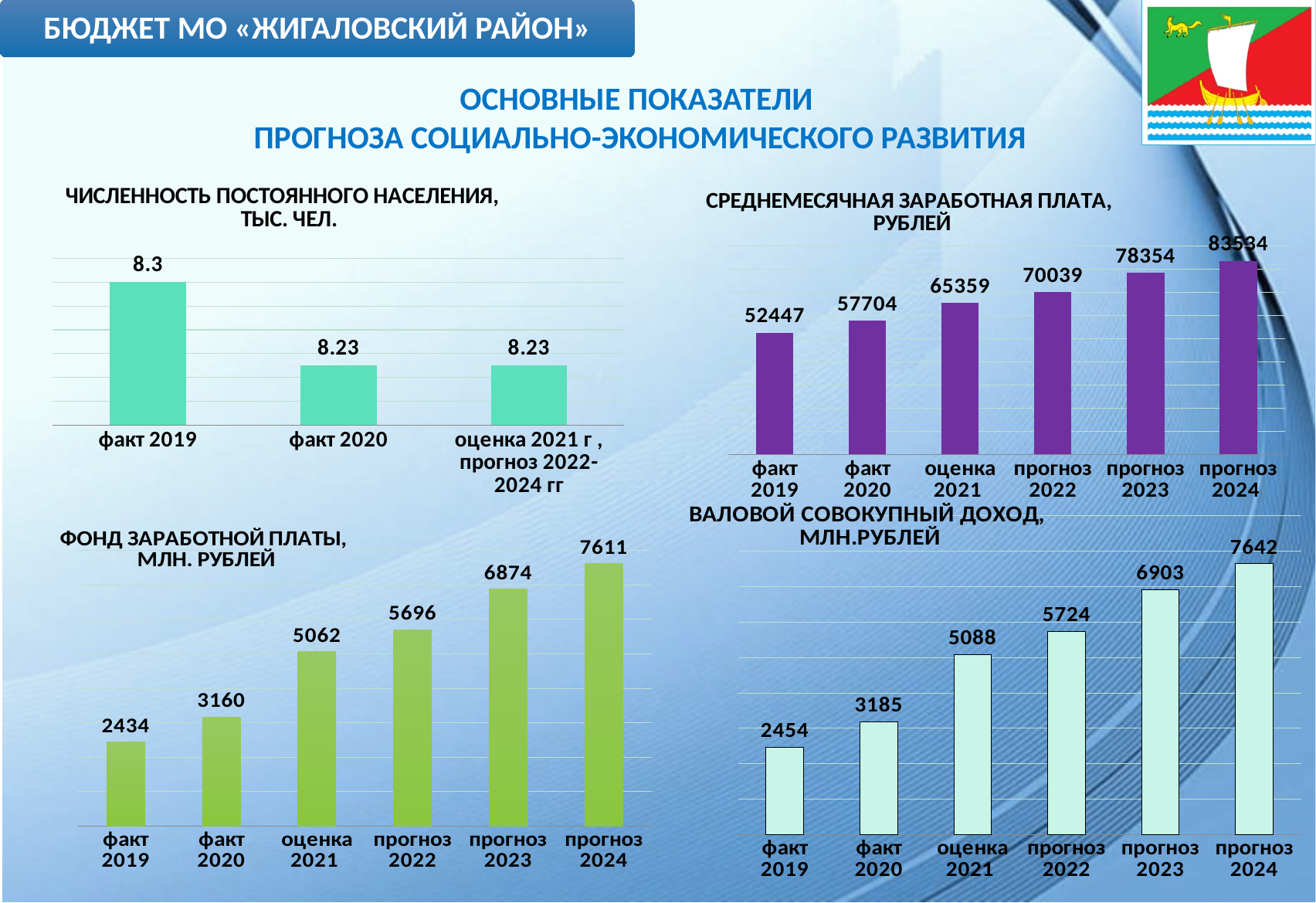
In the chart 'ЧИСЛЕННОСТЬ ПОСТОЯННОГО НАСЕЛЕНИЯ, ТЫС. ЧЕЛ.', what is the difference between факт 2019 and факт 2020? 0.07 In the chart 'ВАЛОВОЙ СОВОКУПНЫЙ ДОХОД, МЛН.РУБЛЕЙ', what is the difference between прогноз 2024 and прогноз 2023? 739 In the chart 'ФОНД ЗАРАБОТНОЙ ПЛАТЫ, МЛН. РУБЛЕЙ', what is the value for оценка 2021? 5062 In the chart 'ЧИСЛЕННОСТЬ ПОСТОЯННОГО НАСЕЛЕНИЯ, ТЫС. ЧЕЛ.', how many bars are plotted? 3 What type of chart is 'ВАЛОВОЙ СОВОКУПНЫЙ ДОХОД, МЛН.РУБЛЕЙ'? bar chart In the chart 'ФОНД ЗАРАБОТНОЙ ПЛАТЫ, МЛН. РУБЛЕЙ', which category has the lowest value? факт 2019 In the chart 'СРЕДНЕМЕСЯЧНАЯ ЗАРАБОТНАЯ ПЛАТА, РУБЛЕЙ', what is the value for прогноз 2022? 70039 In the chart 'ВАЛОВОЙ СОВОКУПНЫЙ ДОХОД, МЛН.РУБЛЕЙ', what is the value for факт 2020? 3185 In the chart 'СРЕДНЕМЕСЯЧНАЯ ЗАРАБОТНАЯ ПЛАТА, РУБЛЕЙ', which category has the highest value? прогноз 2024 In the chart 'ЧИСЛЕННОСТЬ ПОСТОЯННОГО НАСЕЛЕНИЯ, ТЫС. ЧЕЛ.', what is the value for факт 2019? 8.3 In the chart 'СРЕДНЕМЕСЯЧНАЯ ЗАРАБОТНАЯ ПЛАТА, РУБЛЕЙ', what is the difference between прогноз 2024 and факт 2019? 31087 In the chart 'ФОНД ЗАРАБОТНОЙ ПЛАТЫ, МЛН. РУБЛЕЙ', do the values rise or fall from факт 2019 to прогноз 2024? rise